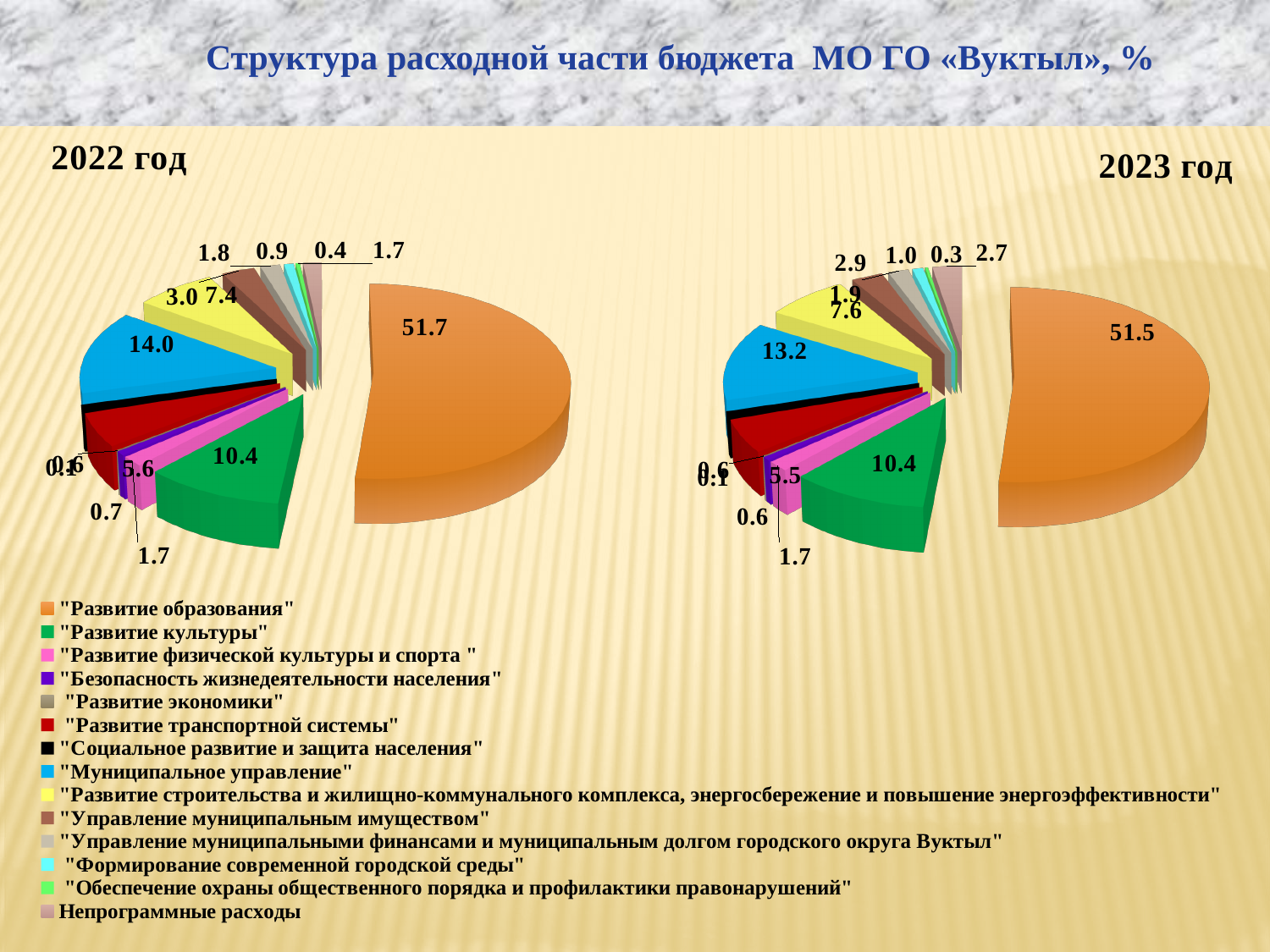
On the 2022 год chart, which category has the largest slice? "Развитие образования" How many pie charts are shown on the slide? 2 What kind of chart is used for the 2022 год and 2023 год data? Pie chart On the 2023 год chart, what value is shown for "Муниципальное управление"? 13.2 On the 2022 год chart, which is larger: "Развитие культуры" or "Муниципальное управление"? "Муниципальное управление" On the 2022 год chart, what share is shown for "Развитие образования"? 51.7 On the 2023 год chart, what value is shown for "Развитие культуры"? 10.4 On the 2022 год chart, what value is shown for "Развитие строительства и жилищно-коммунального комплекса, энергосбережение и повышение энергоэффективности"? 7.4 On the 2022 год chart, what value is shown for "Муниципальное управление"? 14.0 By how much does the "Муниципальное управление" share on the 2022 год chart exceed the one on the 2023 год chart? 0.8 How many categories does the legend list? 14 On the 2023 год chart, what share is shown for "Развитие образования"? 51.5